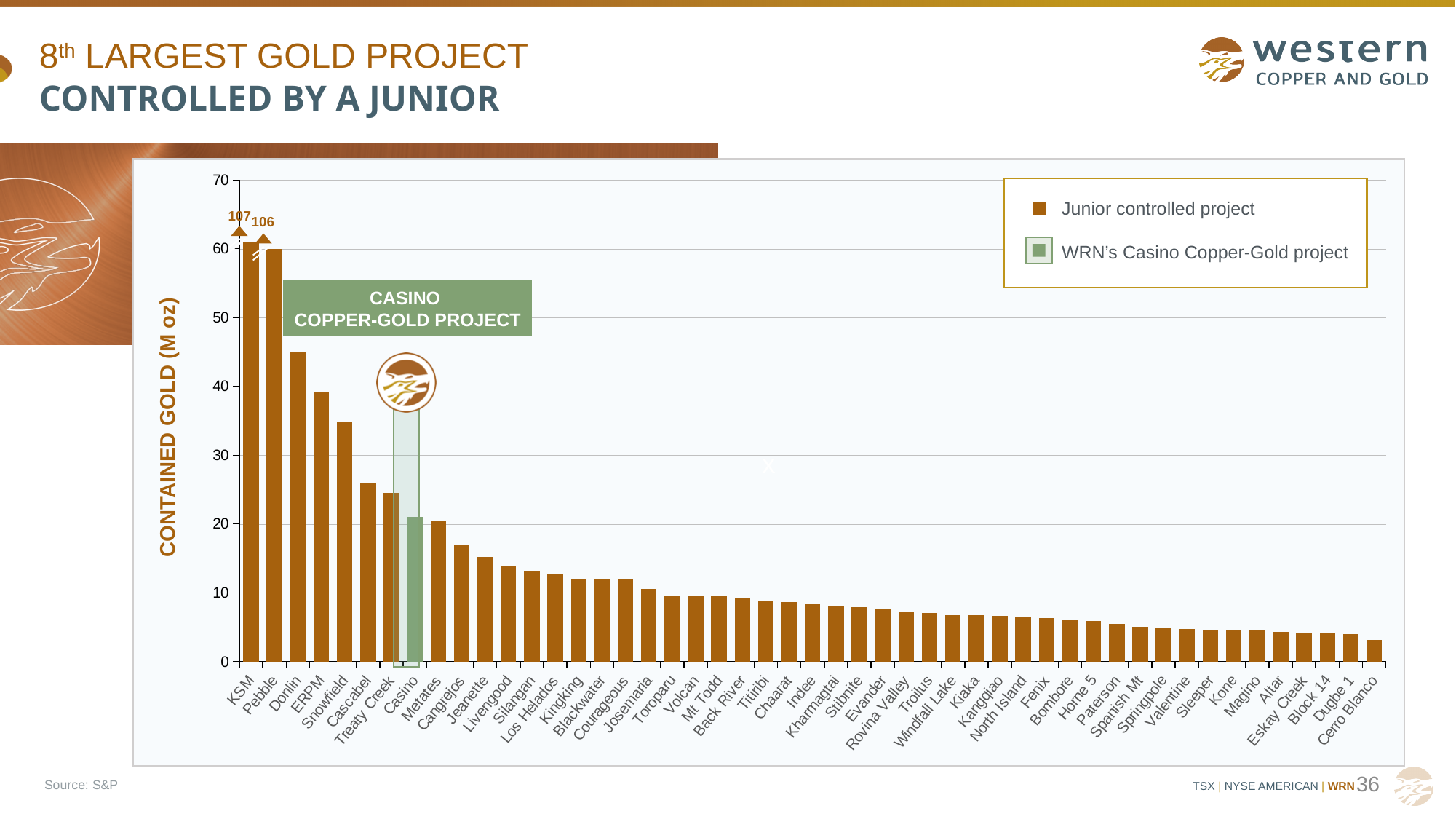
Is the value for Donlin greater or less than 40? greater How many entries does the legend list? 2 What is the contained gold value shown for KSM? 107 Which project has the lowest contained gold? Cerro Blanco What is the difference between the labelled values for KSM and Pebble? 1 Which has more contained gold, Donlin or ERPM? Donlin What kind of chart is shown on the slide? bar chart Is the value for Casino greater or less than 30? less What is the contained gold value shown for Pebble? 106 Do the values rise or fall moving from left to right along the x axis? fall Is the value for Snowfield greater or less than 30? greater Which project has the highest contained gold? KSM